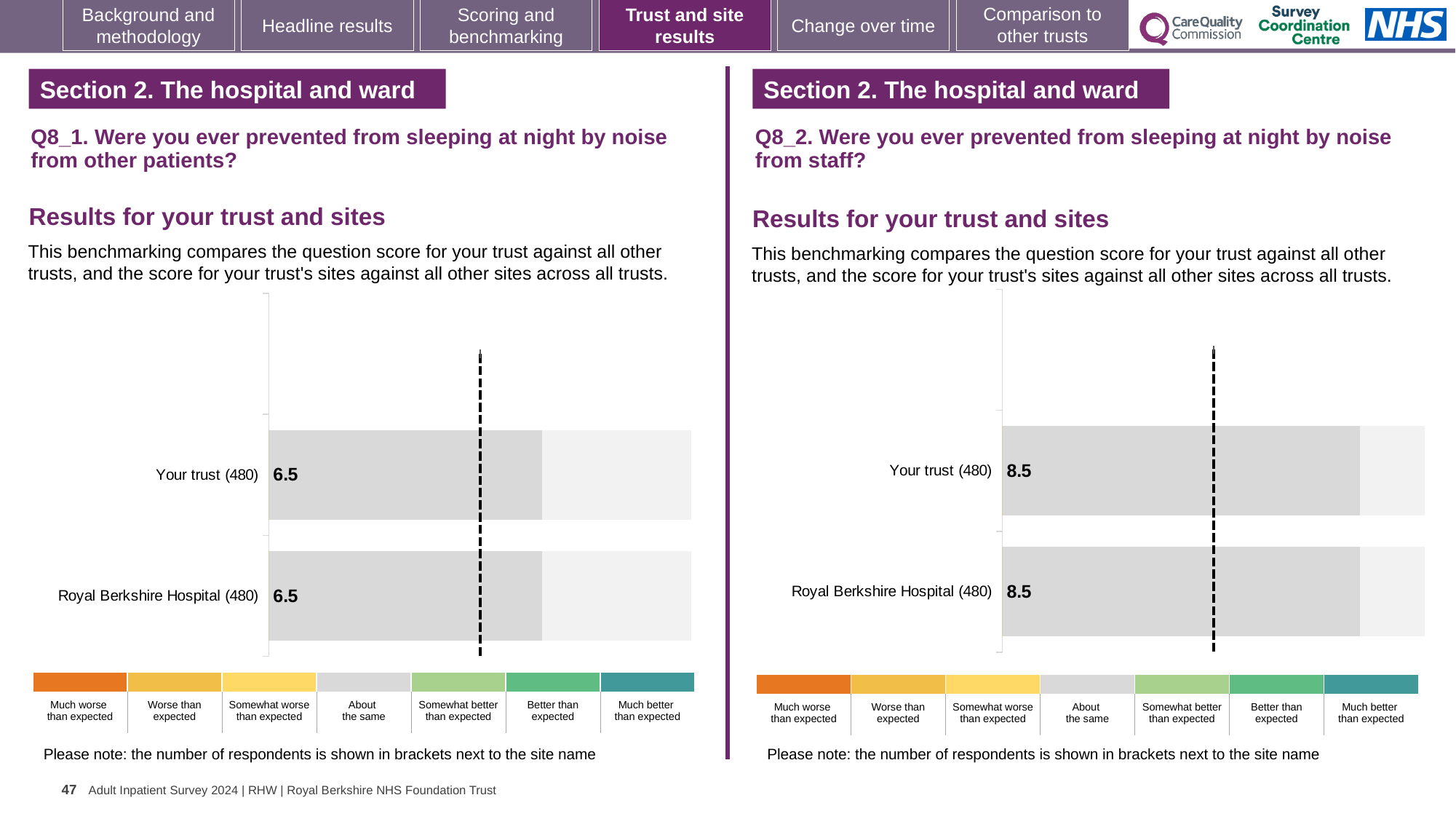
What kind of chart is used for the Q8_2 results (noise from staff)? Bar chart In the Q8_2 chart (noise from staff), what is the score for Your trust? 8.5 In the Q8_2 chart (noise from staff), what is the score for Royal Berkshire Hospital? 8.5 What is the difference between the Your trust score in the Q8_2 chart (8.5) and the Your trust score in the Q8_1 chart (6.5)? 2.0 In the Q8_2 chart (noise from staff), which benchmark category does the Your trust bar fall into according to the colour key? About the same How many bars are plotted in the Q8_1 chart (noise from other patients)? 2 In the Q8_1 chart (noise from other patients), is the score for Your trust greater or less than the score for Royal Berkshire Hospital, or are they equal? Equal In the Q8_1 chart (noise from other patients), what is the score for Royal Berkshire Hospital? 6.5 How many benchmark categories does the colour key below the Q8_1 chart list? 7 Is the Your trust score higher in the Q8_1 chart (noise from other patients) or in the Q8_2 chart (noise from staff)? Q8_2 (noise from staff) In the Q8_1 chart (noise from other patients), how many respondents are shown in brackets for Royal Berkshire Hospital? 480 In the Q8_1 chart (noise from other patients), what is the score for Your trust? 6.5